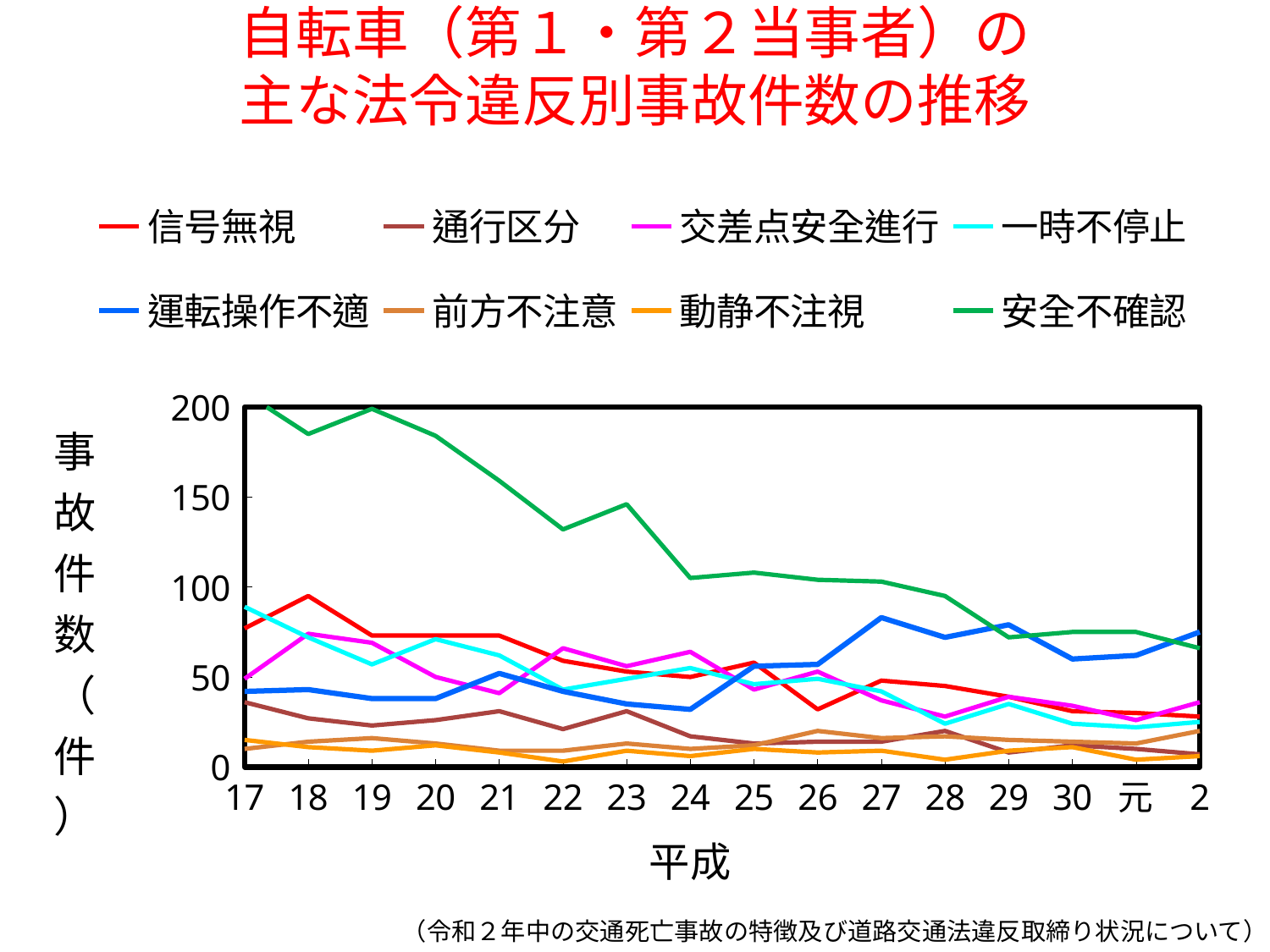
Does the 安全不確認 series rise or fall overall from 17 to 2? fall Is the value for 安全不確認 at 22 greater or less than 100? greater Is the value for 動静不注視 at 22 greater or less than 50? less Is the value for 安全不確認 at 2 greater or less than 100? less Which series has the highest value at 17? 安全不確認 Which is larger at 27, 運転操作不適 or 信号無視? 運転操作不適 What is the label on the x axis? 平成 What colour is the 安全不確認 line in the legend? green What kind of chart is shown on the slide? line chart How many series does the legend list? 8 How many points are labelled along the x axis? 16